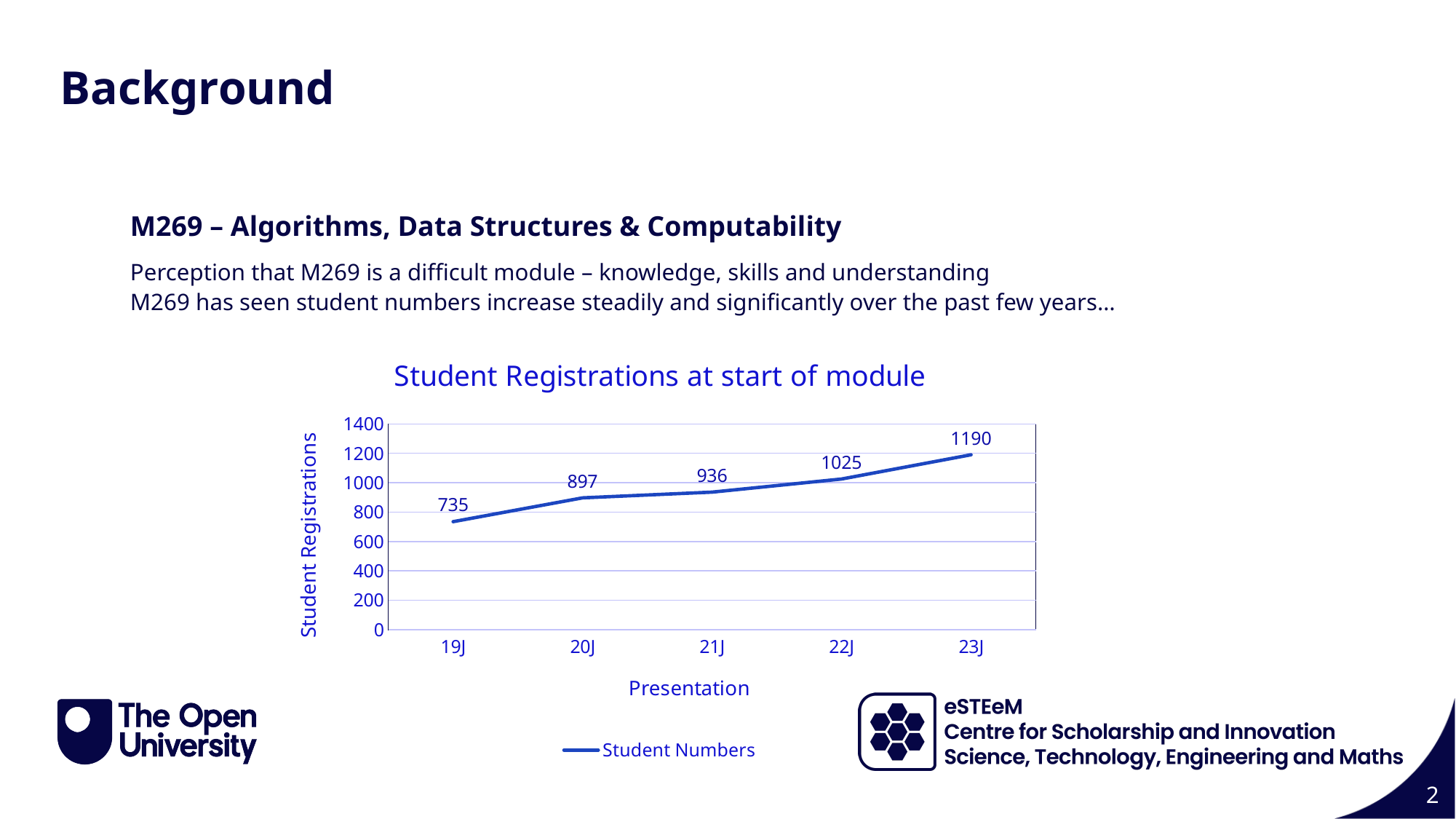
What is the value for 21J? 936 What is the difference between the values for 22J and 21J? 89 Which is larger, the value for 20J or the value for 22J? 22J What is the value for 19J? 735 How many presentations are plotted on the x axis? 5 Which presentation has the highest number of student registrations? 23J Is the value for 20J greater or less than 1000? less What is the difference between the values for 23J and 19J? 455 Which presentation has the lowest number of student registrations? 19J What kind of chart is shown? line chart Do the values rise or fall from 19J to 23J? rise What is the value for 23J? 1190